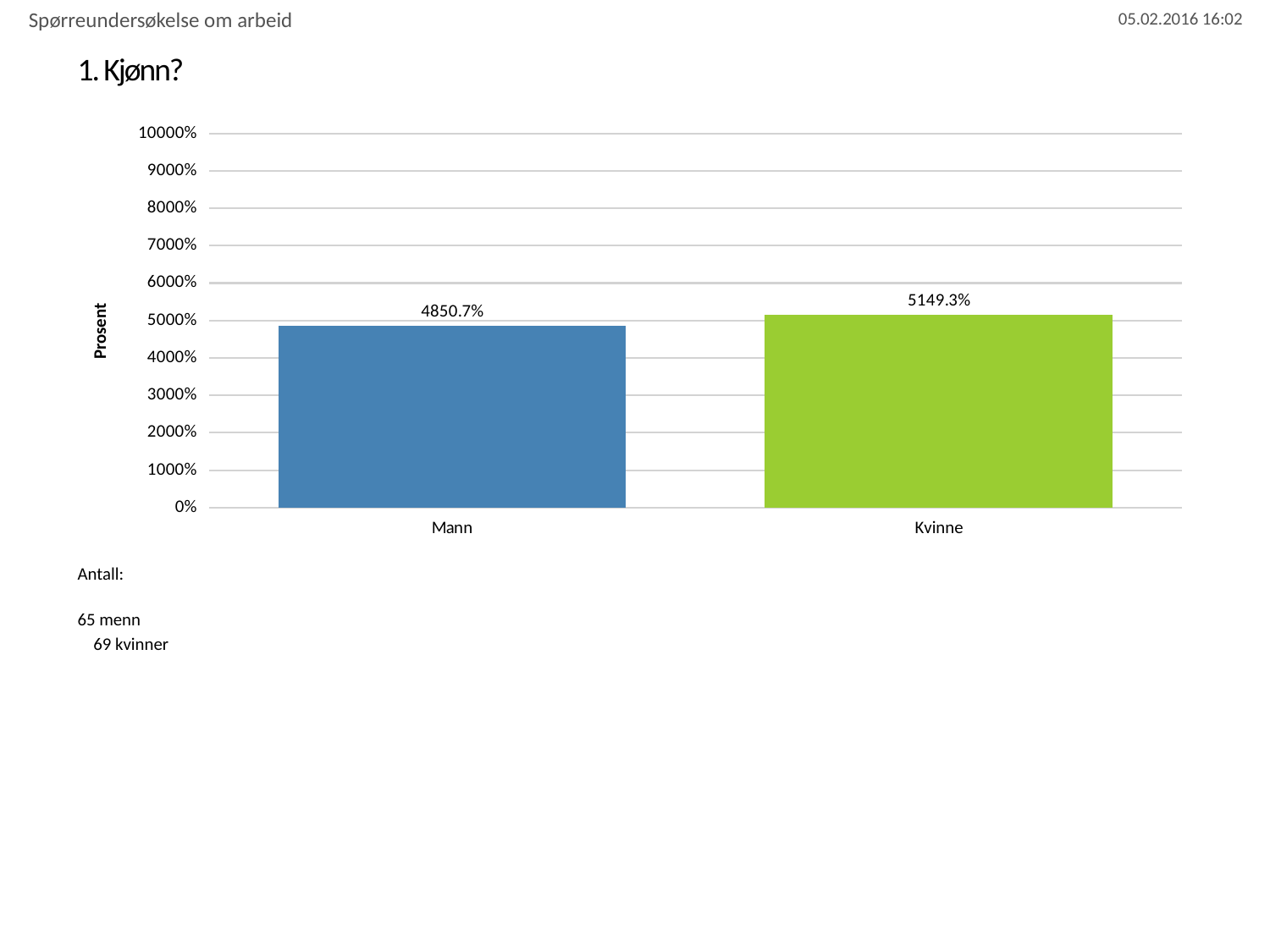
Is the value for Kvinne greater or less than 5000%? greater Is the value for Mann greater or less than 5000%? less What kind of chart is shown on the slide? bar chart What is the title of the chart? 1. Kjønn? What is the label of the y axis? Prosent What is the difference between the values for Kvinne and Mann? 298.6% How many categories are shown on the x axis? 2 What is the value for Kvinne? 5149.3% Which category has the lowest value? Mann Which is larger, the value for Mann or the value for Kvinne? Kvinne What is the value for Mann? 4850.7% Which category has the highest value? Kvinne